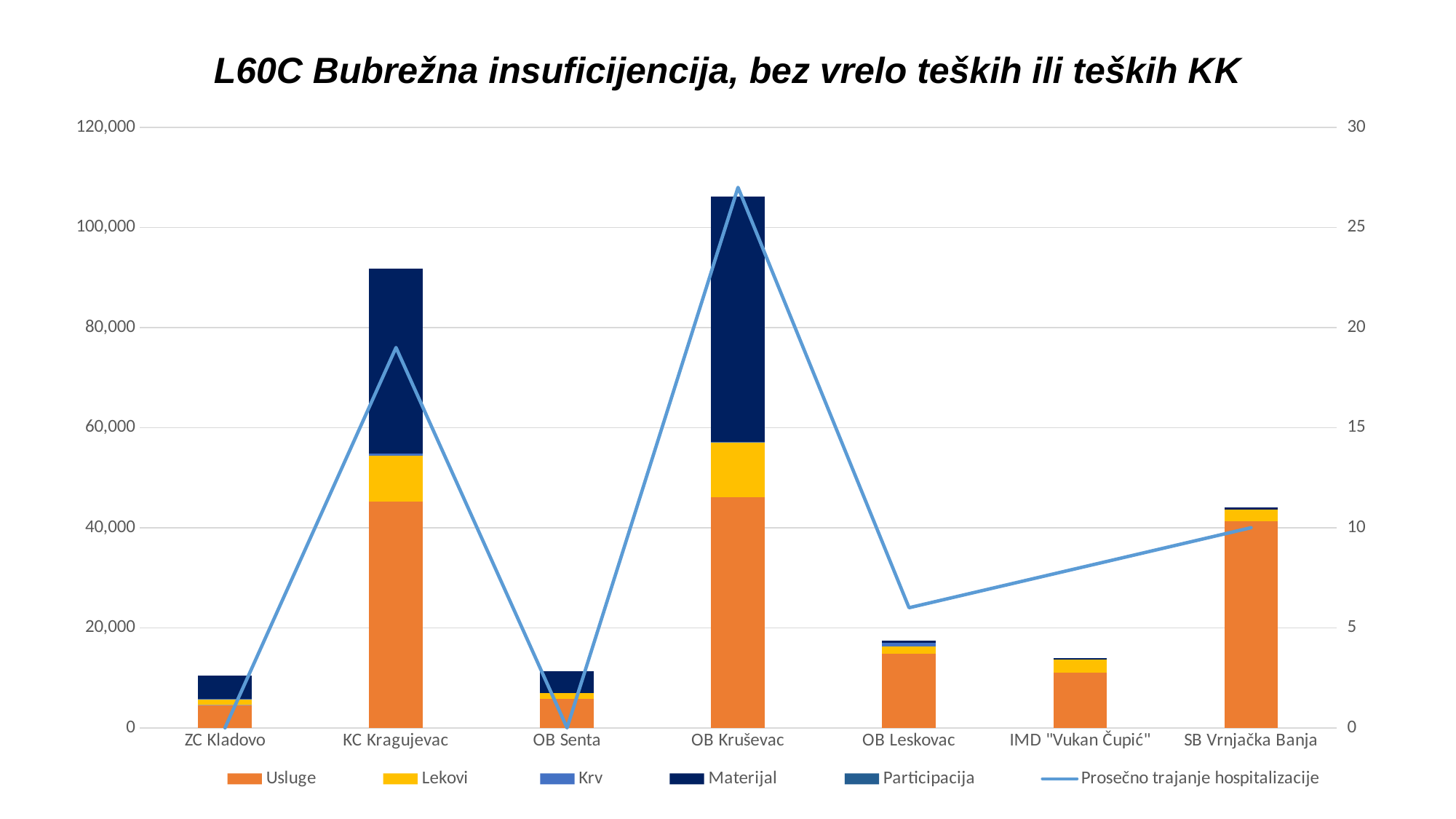
Is the 'Prosečno trajanje hospitalizacije' value for KC Kragujevac greater or less than 15? greater Is the total stacked bar for OB Kruševac greater or less than 100,000? greater Is the 'Prosečno trajanje hospitalizacije' value for OB Leskovac greater or less than 10? less What is the title of the chart? L60C Bubrežna insuficijencija, bez vrelo teških ili teških KK Which institution has the larger 'Materijal' segment, KC Kragujevac or OB Kruševac? OB Kruševac Which has the taller stacked bar, KC Kragujevac or SB Vrnjačka Banja? KC Kragujevac How many institutions (categories) are shown on the x axis? 7 How many series does the legend list? 6 Which institution has the tallest stacked bar? OB Kruševac Which institution has the highest value on the 'Prosečno trajanje hospitalizacije' line? OB Kruševac What kind of chart is shown on the slide? bar chart with a line